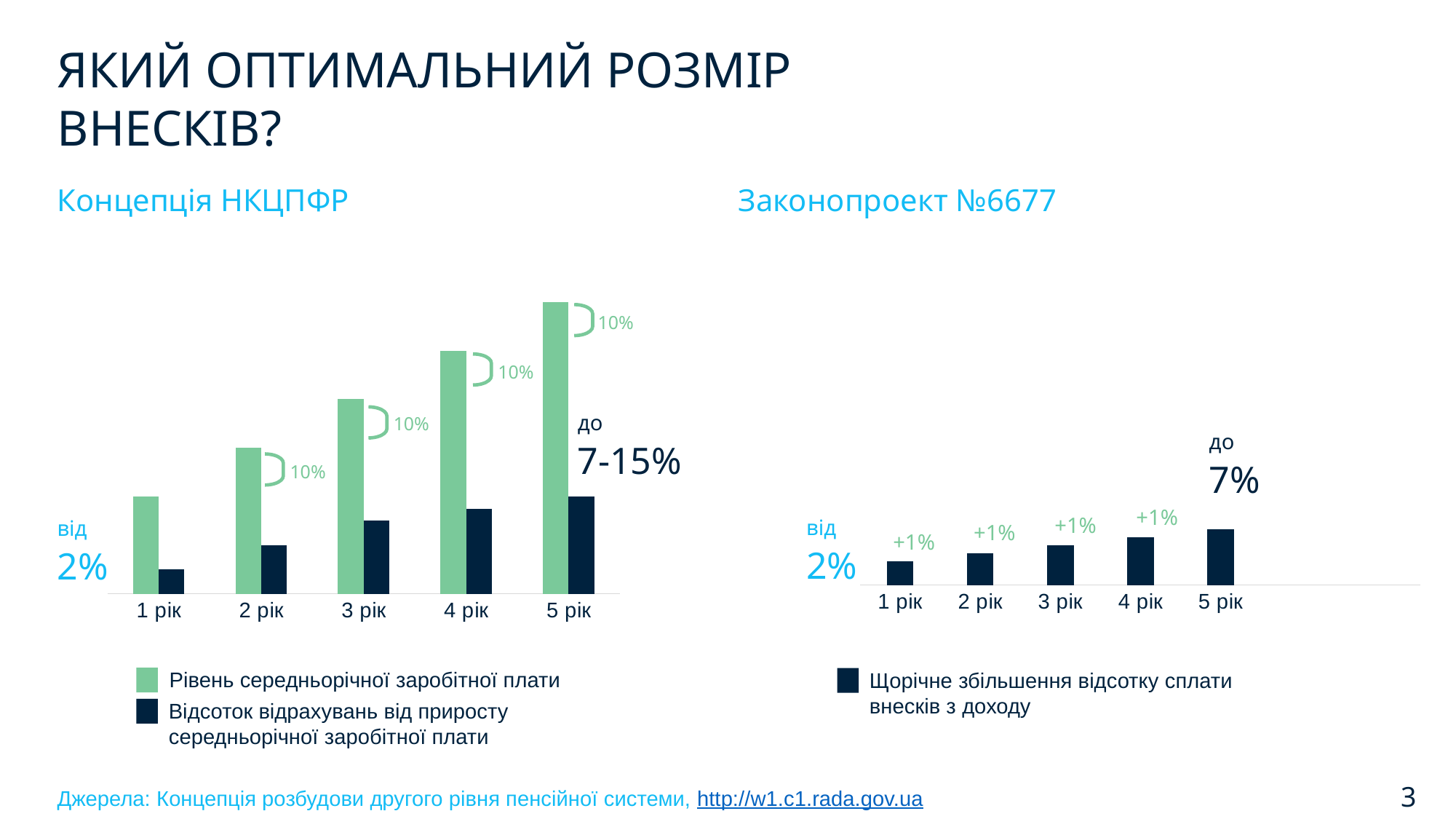
In the left chart "Концепція НКЦПФР", what upper range is labelled next to the 5 рік bar ("до")? 7-15% In the right chart "Законопроект №6677", how many series does the legend list? 1 In the right chart "Законопроект №6677", what annual increase is labelled above the bars from 2 рік onward? +1% In the left chart "Концепція НКЦПФР", do the green bars rise or fall from 1 рік to 5 рік? rise In the right chart "Законопроект №6677", which year has the shortest bar? 1 рік In the left chart "Концепція НКЦПФР", which year has the tallest dark bar? 5 рік In the left chart "Концепція НКЦПФР", how many series does the legend list? 2 In the right chart "Законопроект №6677", how many year categories are shown? 5 In the right chart "Законопроект №6677", do the bars rise or fall from 1 рік to 5 рік? rise What type of chart is the left chart titled "Концепція НКЦПФР"? bar chart In the left chart "Концепція НКЦПФР", how many year categories are shown on the x axis? 5 In the right chart "Законопроект №6677", what starting value is labelled "від" at the left of the bars? 2%